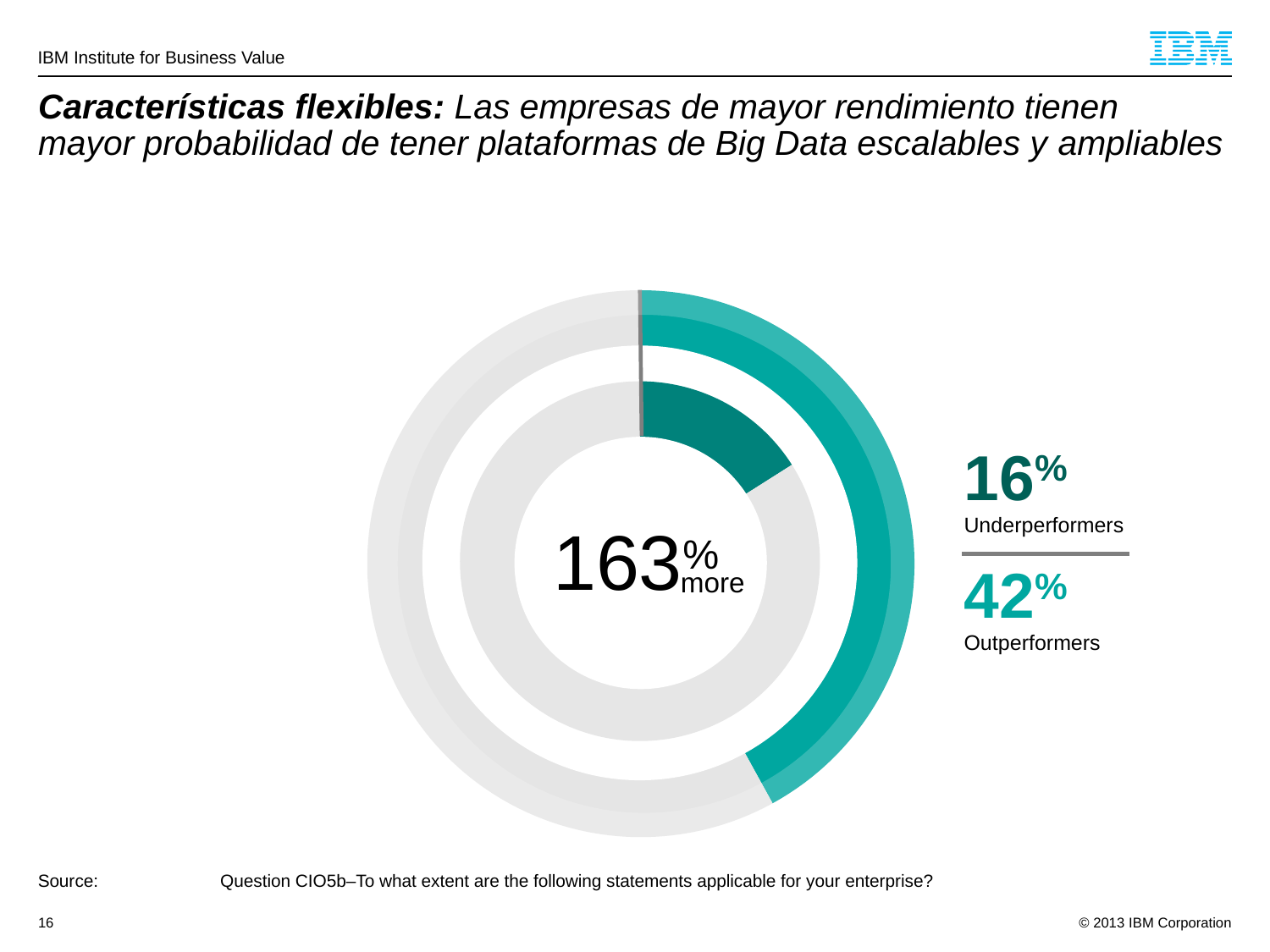
Is the value for Outperformers greater or less than 40%? greater What percentage is shown for Outperformers? 42% What percentage is shown for Underperformers? 16% What figure is printed in the centre of the chart? 163% more What is the difference in percentage points between Outperformers and Underperformers? 26 Which group has the lowest percentage shown on the chart? Underperformers What kind of chart is shown on the slide? Doughnut chart Which group has the higher percentage, Underperformers or Outperformers? Outperformers Which group is represented by the outer ring of the chart? Outperformers How many groups are shown on the chart? 2